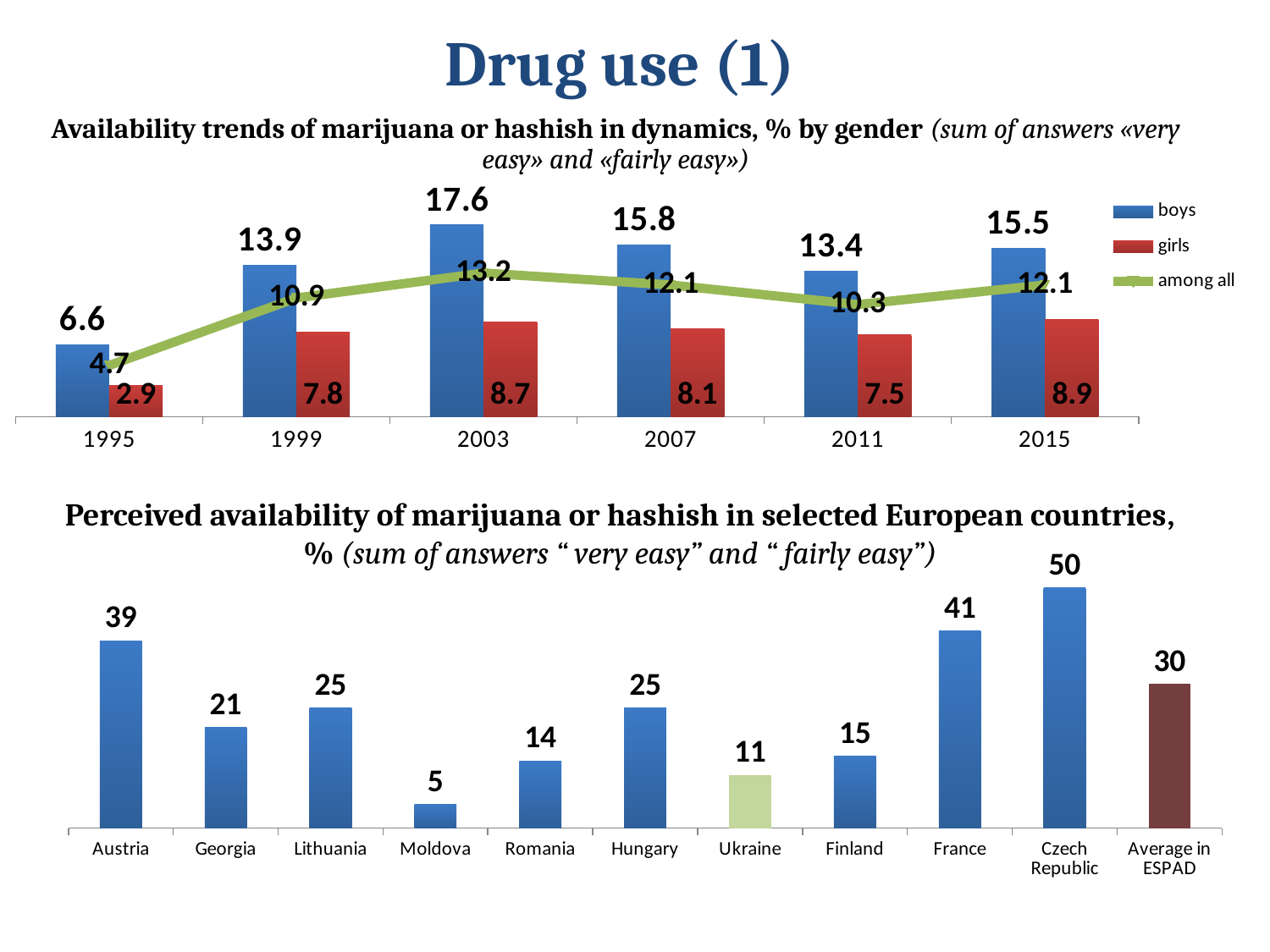
In the bottom chart (Perceived availability of marijuana or hashish in selected European countries), what is the difference between the values for France and Finland? 26 In the top chart (Availability trends of marijuana or hashish in dynamics), what is the difference between the boys' and girls' values in 2015? 6.6 In the top chart (Availability trends of marijuana or hashish in dynamics), what is the value for girls in 1995? 2.9 In the bottom chart (Perceived availability of marijuana or hashish in selected European countries), which country has the highest value? Czech Republic In the bottom chart (Perceived availability of marijuana or hashish in selected European countries), what is the value for Ukraine? 11 In the top chart (Availability trends of marijuana or hashish in dynamics), what is the value for boys in 2003? 17.6 In the bottom chart (Perceived availability of marijuana or hashish in selected European countries), how many categories are shown on the x axis? 11 In the top chart (Availability trends of marijuana or hashish in dynamics), how many series does the legend list? 3 In the top chart (Availability trends of marijuana or hashish in dynamics), in which year is the boys' value highest? 2003 In the bottom chart (Perceived availability of marijuana or hashish in selected European countries), which country has the lowest value? Moldova In the top chart (Availability trends of marijuana or hashish in dynamics), does the girls' value rise or fall from 1995 to 1999? rise In the top chart (Availability trends of marijuana or hashish in dynamics), what is the 'among all' value for 2011? 10.3